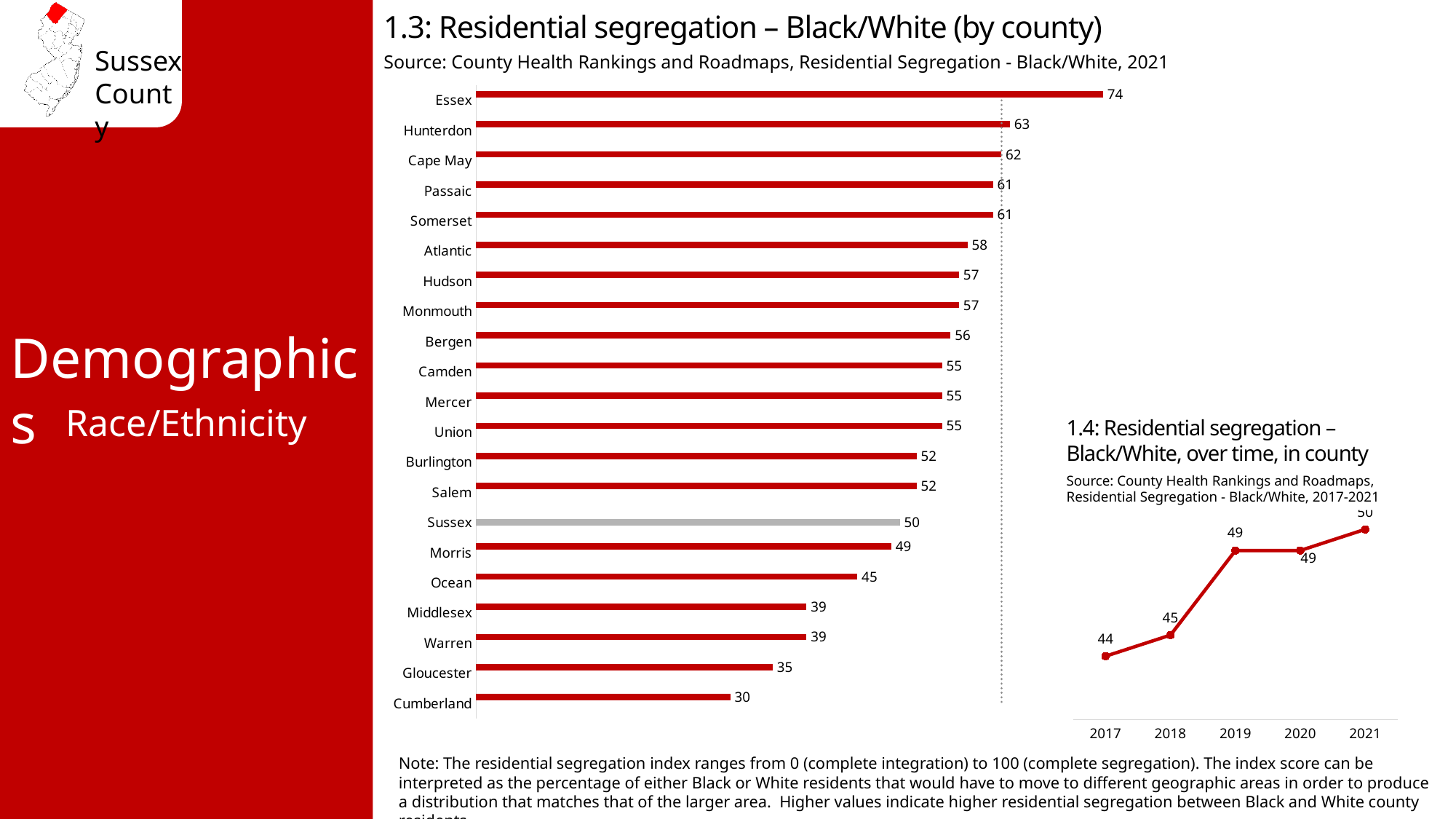
In chart 1.3 (by county), which county has the lowest residential segregation index? Cumberland In chart 1.3 (Residential segregation – Black/White by county), what is the value for Sussex? 50 In chart 1.3 (by county), how many counties are shown? 21 In chart 1.4 (over time), how many years are plotted? 5 In chart 1.3 (by county), what is the value for Essex? 74 In chart 1.4 (over time), what is the difference between the 2021 and 2017 values? 6 In chart 1.3 (by county), which has a higher value, Morris or Ocean? Morris What kind of chart is chart 1.3 (Residential segregation – Black/White by county)? Bar chart In chart 1.3 (by county), what is the difference between the values for Essex and Cumberland? 44 In chart 1.4 (Residential segregation – Black/White over time), what is the value for 2017? 44 In chart 1.4 (over time), do the values generally rise or fall from 2017 to 2021? Rise In chart 1.3 (by county), which county has the highest residential segregation index? Essex